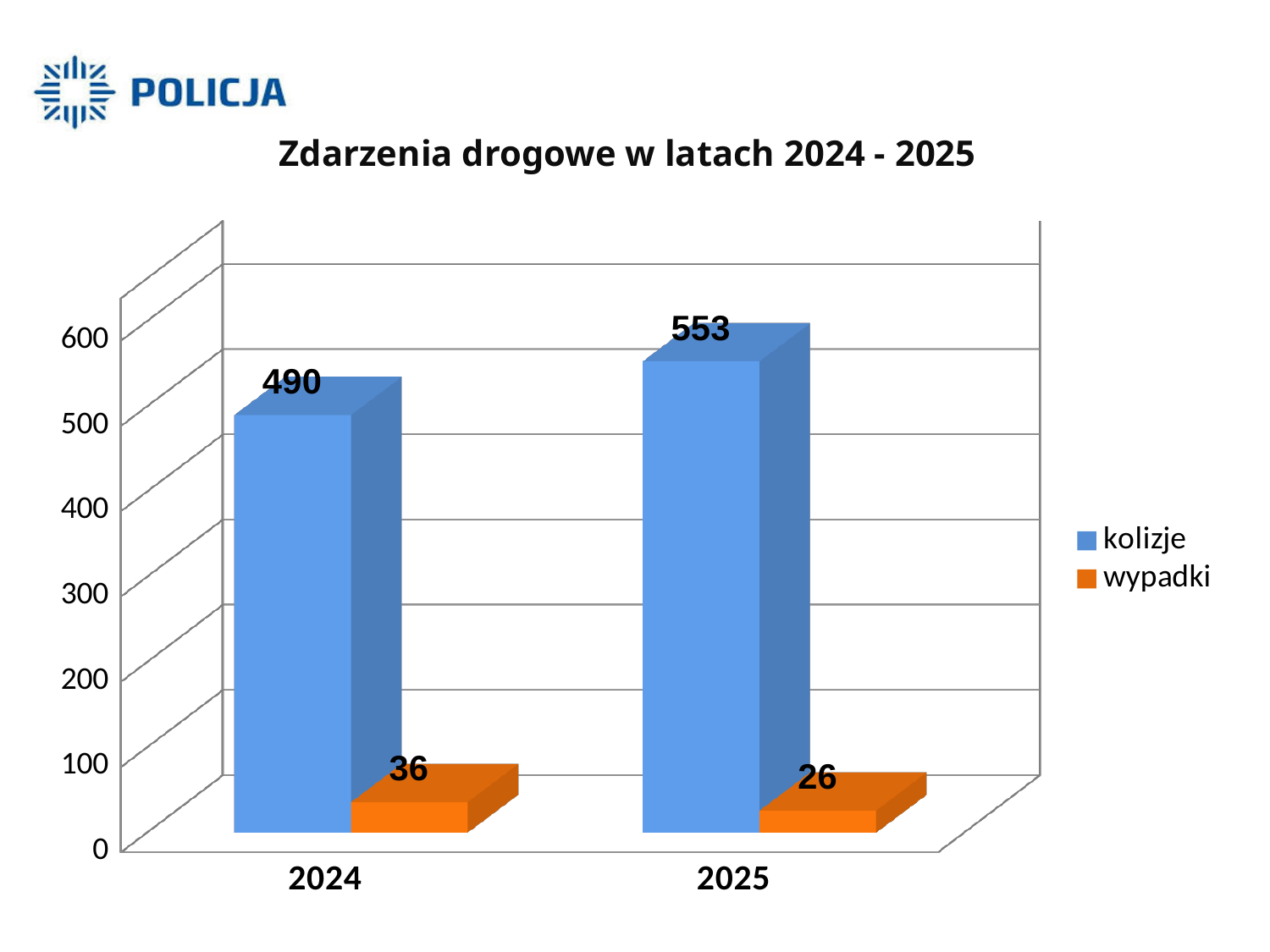
What is the difference between wypadki in 2024 and wypadki in 2025? 10 What is the value for kolizje in 2024? 490 What is the title of the chart? Zdarzenia drogowe w latach 2024 - 2025 Which year has the lower value for wypadki? 2025 What is the difference between kolizje in 2025 and kolizje in 2024? 63 Which year has the higher value for kolizje? 2025 What is the value for kolizje in 2025? 553 What is the value for wypadki in 2025? 26 How many series does the legend list? 2 What is the value for wypadki in 2024? 36 Which is larger: wypadki in 2024 or wypadki in 2025? wypadki in 2024 What kind of chart is shown on the slide? bar chart